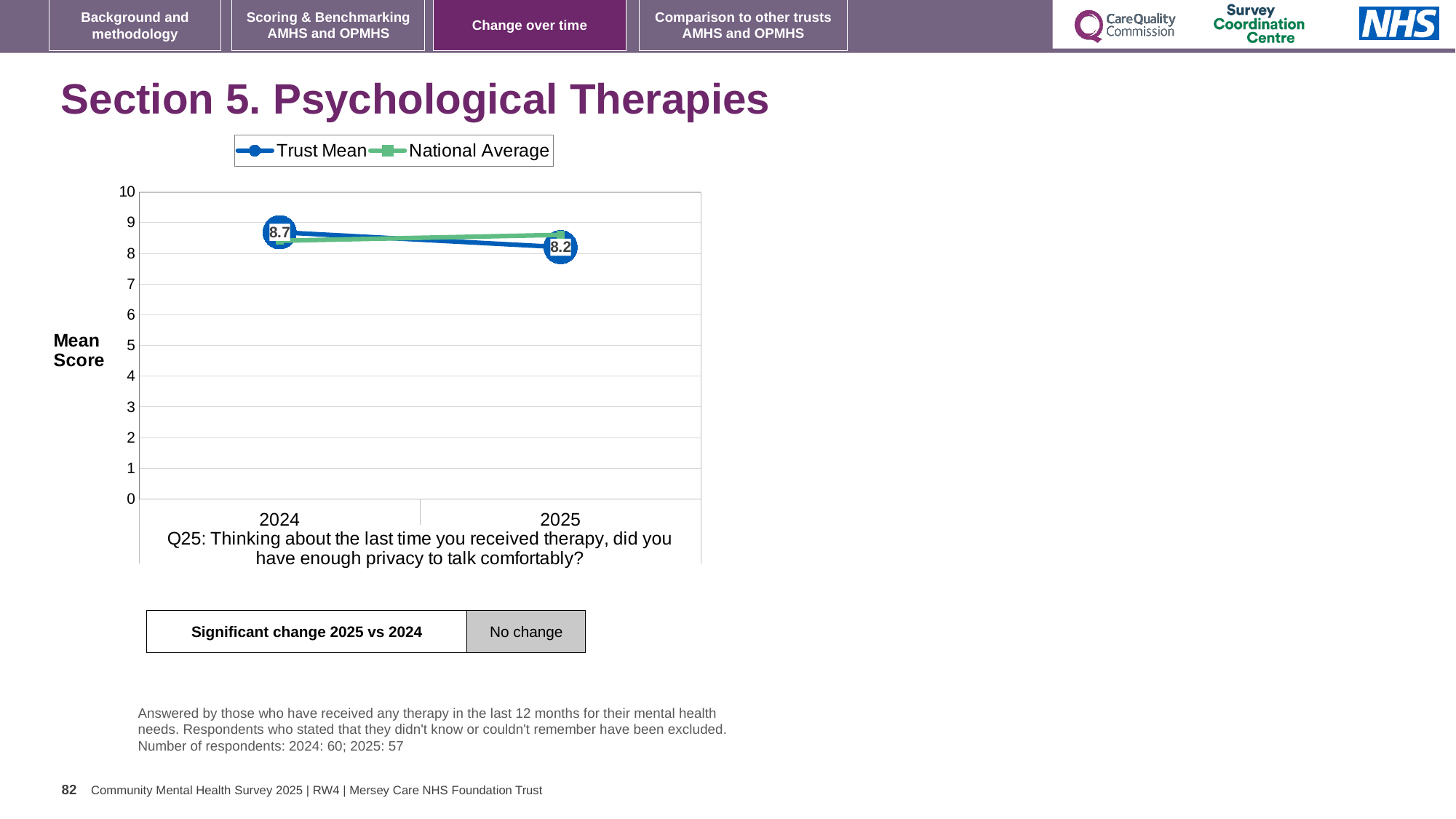
What is the Trust Mean value for 2025? 8.2 Which year has the higher Trust Mean, 2024 or 2025? 2024 What are the two series named in the legend? Trust Mean and National Average In which year is the Trust Mean highest? 2024 Is the National Average value for 2024 greater or less than 8? greater What is the label on the y axis of the chart? Mean Score What is the Trust Mean value for 2024? 8.7 How many series does the legend list? 2 What kind of chart is shown on the slide? line chart By how much did the Trust Mean change from 2024 to 2025? 0.5 How many years are plotted on the x axis? 2 Does the Trust Mean rise or fall from 2024 to 2025? fall